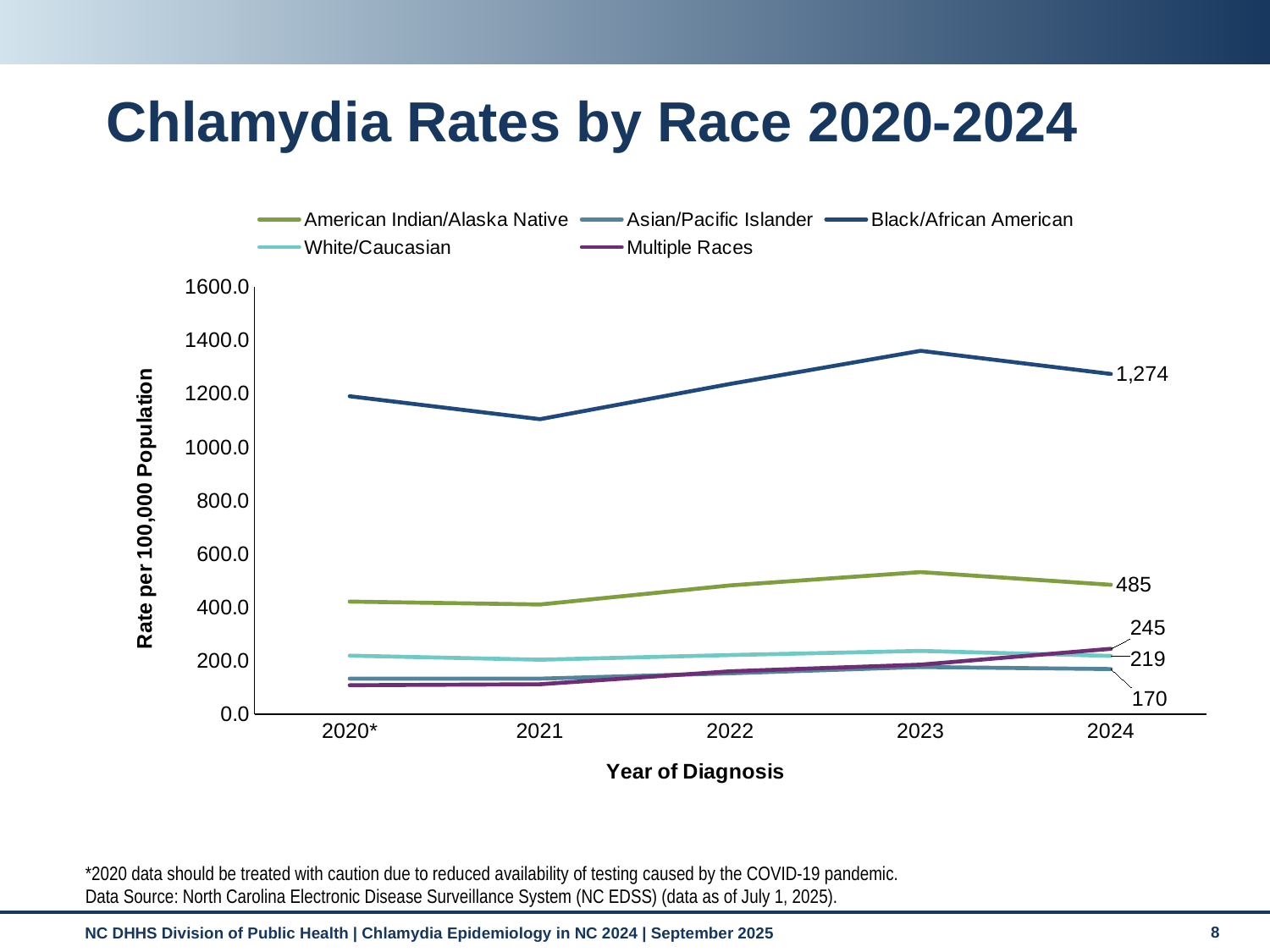
Which race group has the highest chlamydia rate in 2024? Black/African American What is the difference between the 2024 rates for Black/African American and American Indian/Alaska Native? 789 What is the chlamydia rate for Black/African American in 2024? 1,274 What is the label of the y axis? Rate per 100,000 Population What is the chlamydia rate for White/Caucasian in 2024? 219 What is the chlamydia rate for American Indian/Alaska Native in 2024? 485 Is the 2021 rate for Black/African American greater or less than 1000.0? greater What is the chlamydia rate for Multiple Races in 2024? 245 What is the chlamydia rate for Asian/Pacific Islander in 2024? 170 What kind of chart is shown on the slide? Line chart How many series does the legend list? 5 Which race group has the lowest chlamydia rate in 2024? Asian/Pacific Islander